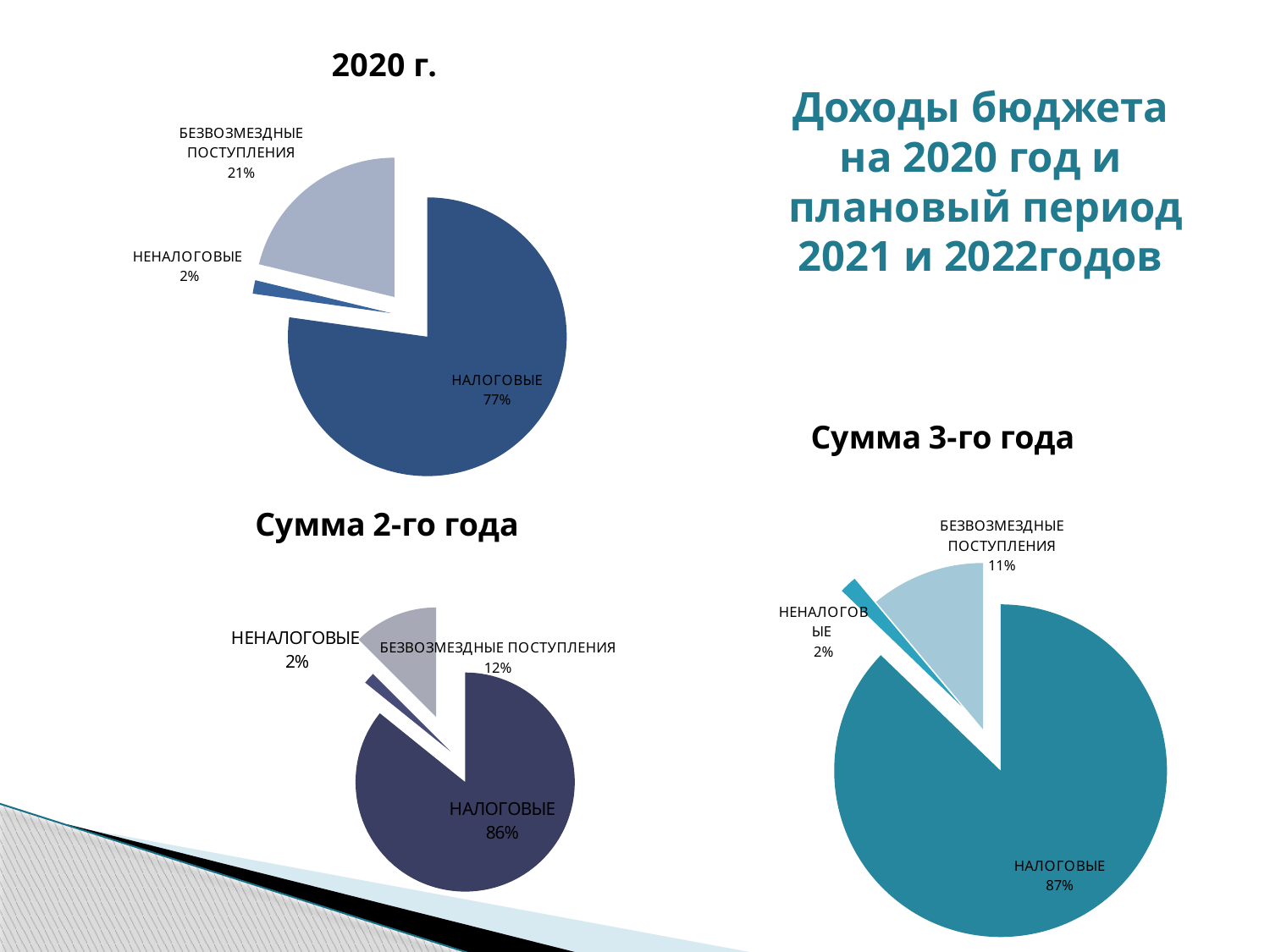
In the "Сумма 2-го года" pie chart, what share is labelled for БЕЗВОЗМЕЗДНЫЕ ПОСТУПЛЕНИЯ? 12% In the "Сумма 3-го года" pie chart, which category has the largest share? НАЛОГОВЫЕ What type of chart is used for "Сумма 3-го года"? Pie chart In the "Сумма 3-го года" pie chart, what share is labelled for НАЛОГОВЫЕ? 87% How many slices does the "Сумма 2-го года" pie chart have? 3 In the "2020 г." pie chart, which category has the smallest share? НЕНАЛОГОВЫЕ In the "2020 г." pie chart, what share is labelled for БЕЗВОЗМЕЗДНЫЕ ПОСТУПЛЕНИЯ? 21% Which is larger: the share of БЕЗВОЗМЕЗДНЫЕ ПОСТУПЛЕНИЯ in the "2020 г." chart or in the "Сумма 3-го года" chart? 2020 г. In the "2020 г." pie chart, what share is labelled for НАЛОГОВЫЕ? 77% In the "2020 г." pie chart, what is the difference in percentage points between НАЛОГОВЫЕ and БЕЗВОЗМЕЗДНЫЕ ПОСТУПЛЕНИЯ? 56 percentage points In the "Сумма 2-го года" pie chart, what share is labelled for НАЛОГОВЫЕ? 86% In the "Сумма 3-го года" pie chart, what share is labelled for НЕНАЛОГОВЫЕ? 2%